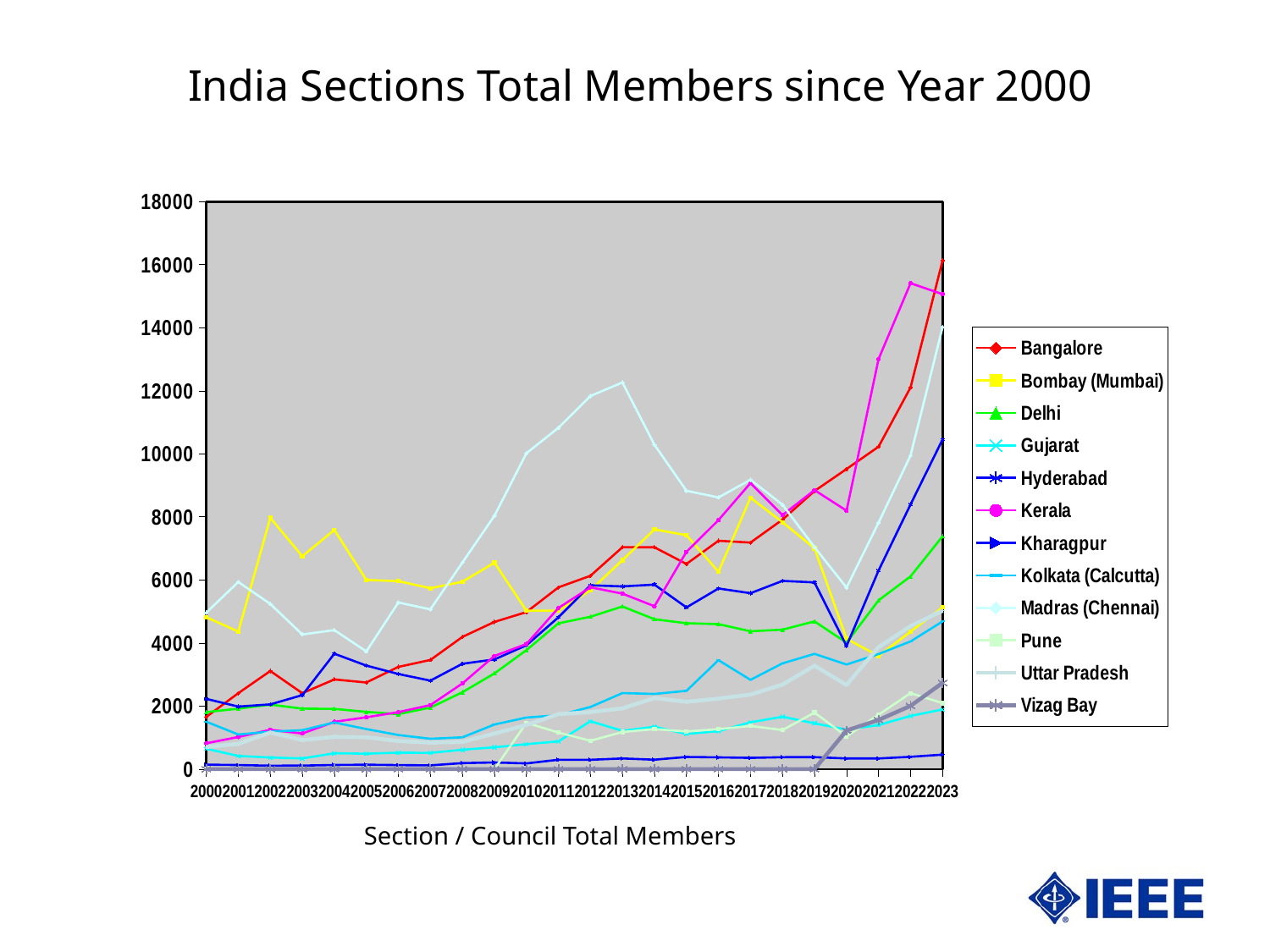
What is the highest tick value shown on the y axis? 18000 Which section has the highest number of members in 2022? Kerala How many years are plotted along the x axis? 24 Does the Bangalore series generally rise or fall from 2000 to 2023? rise In 2023, which is larger: the value for Kerala or the value for Bombay (Mumbai)? Kerala How many series does the legend list? 12 What kind of chart is shown on the slide? line chart Which section has the highest number of members in 2023? Bangalore Is the value for Bombay (Mumbai) in 2002 greater or less than 6000? greater Is the value for Bangalore in 2023 greater or less than 14000? greater What is the title of the chart? India Sections Total Members since Year 2000 Is the value for Vizag Bay in 2023 greater or less than 4000? less